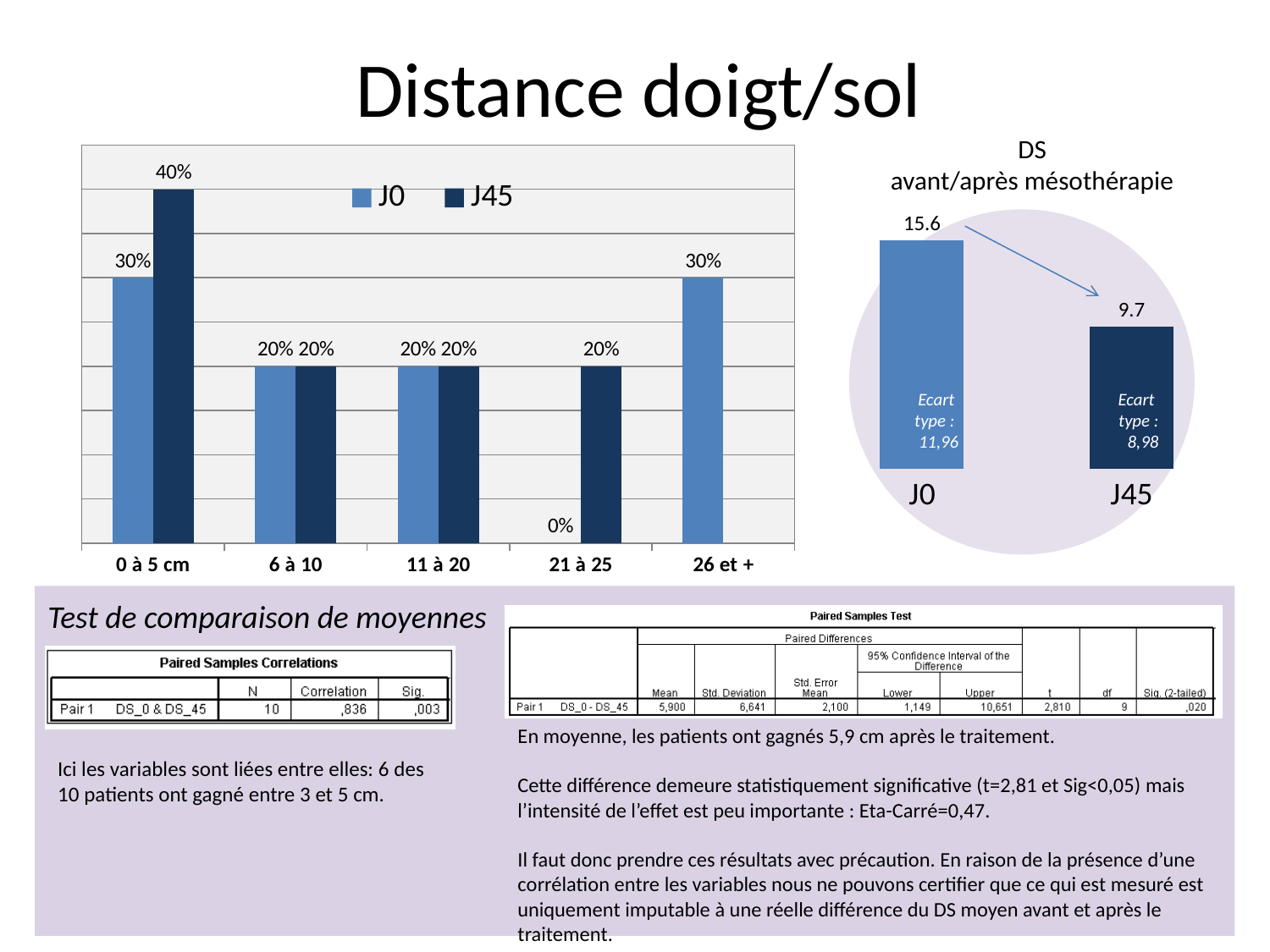
In the chart titled 'DS avant/après mésothérapie', what is the value for J0? 15.6 In the chart titled 'DS avant/après mésothérapie', what is the difference between the J0 and J45 values? 5.9 In the left bar chart, what is the J0 value for the 26 et + category? 30% In the left bar chart, what is the difference between the J45 and J0 values for the 0 à 5 cm category? 10% How many series does the legend of the left bar chart list? 2 How many categories are shown on the x axis of the left bar chart? 5 In the left bar chart, which category has the highest J45 value? 0 à 5 cm In the left bar chart, which category has the lowest J0 value? 21 à 25 What kind of chart is the left chart? Bar chart In the left bar chart, what is the J0 value for the 21 à 25 category? 0% In the left bar chart, what is the J45 value for the 0 à 5 cm category? 40% In the left bar chart, which is larger for the 21 à 25 category, J0 or J45? J45